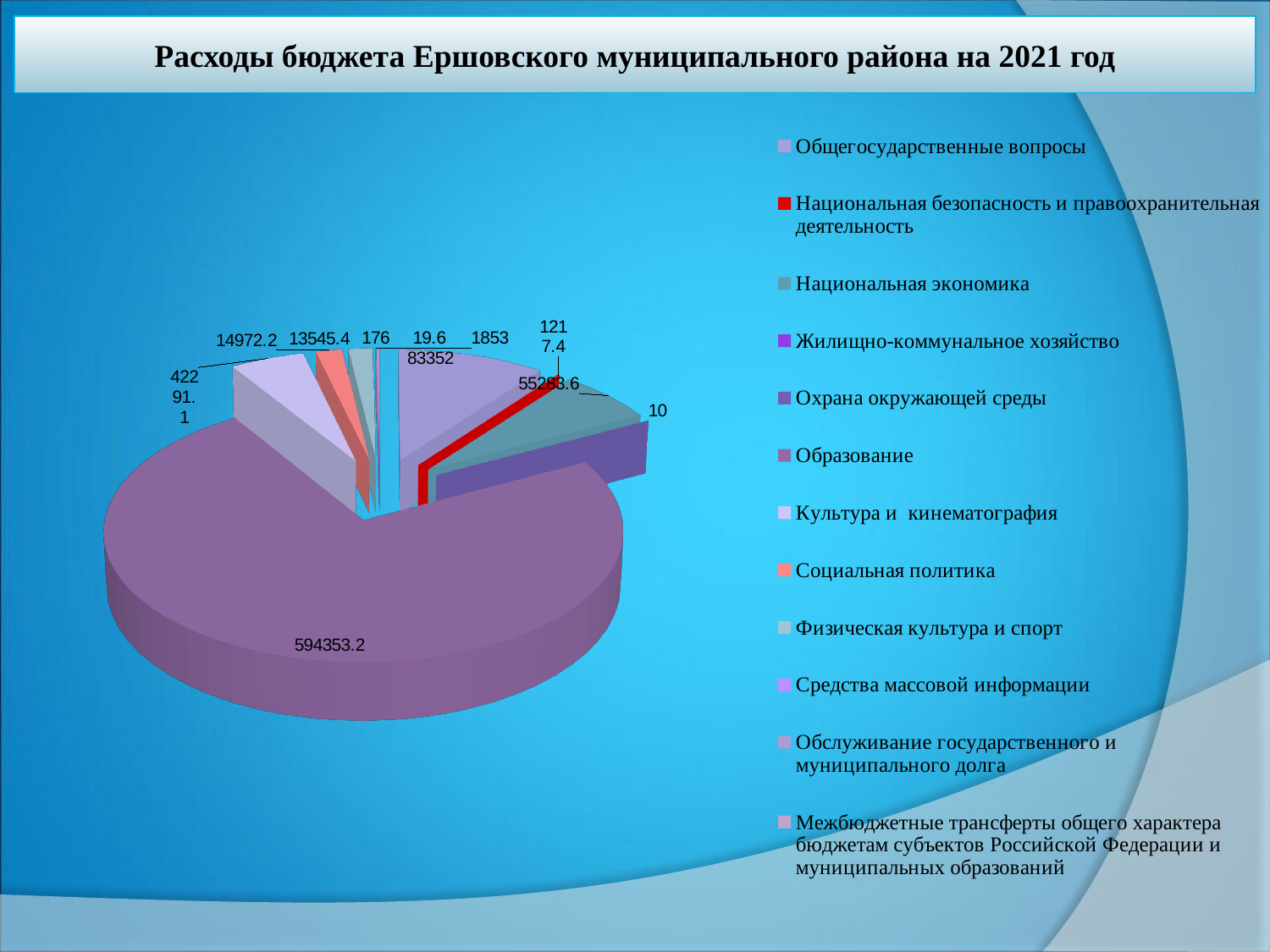
What is the difference between the values for Общегосударственные вопросы and Национальная экономика? 28068.4 Which category has the largest slice of the pie? Образование What is the title of the chart? Расходы бюджета Ершовского муниципального района на 2021 год What is the value for Общегосударственные вопросы? 83352 What is the smallest value labelled on the pie chart? 10 How many categories does the legend list? 12 What is the value for Национальная экономика? 55283.6 What is the value of the largest slice of the pie? 594353.2 Which is larger, the slice for Образование or the slice for Общегосударственные вопросы? Образование What kind of chart is shown on the slide? pie chart Is the value for Образование greater or less than 500000? greater